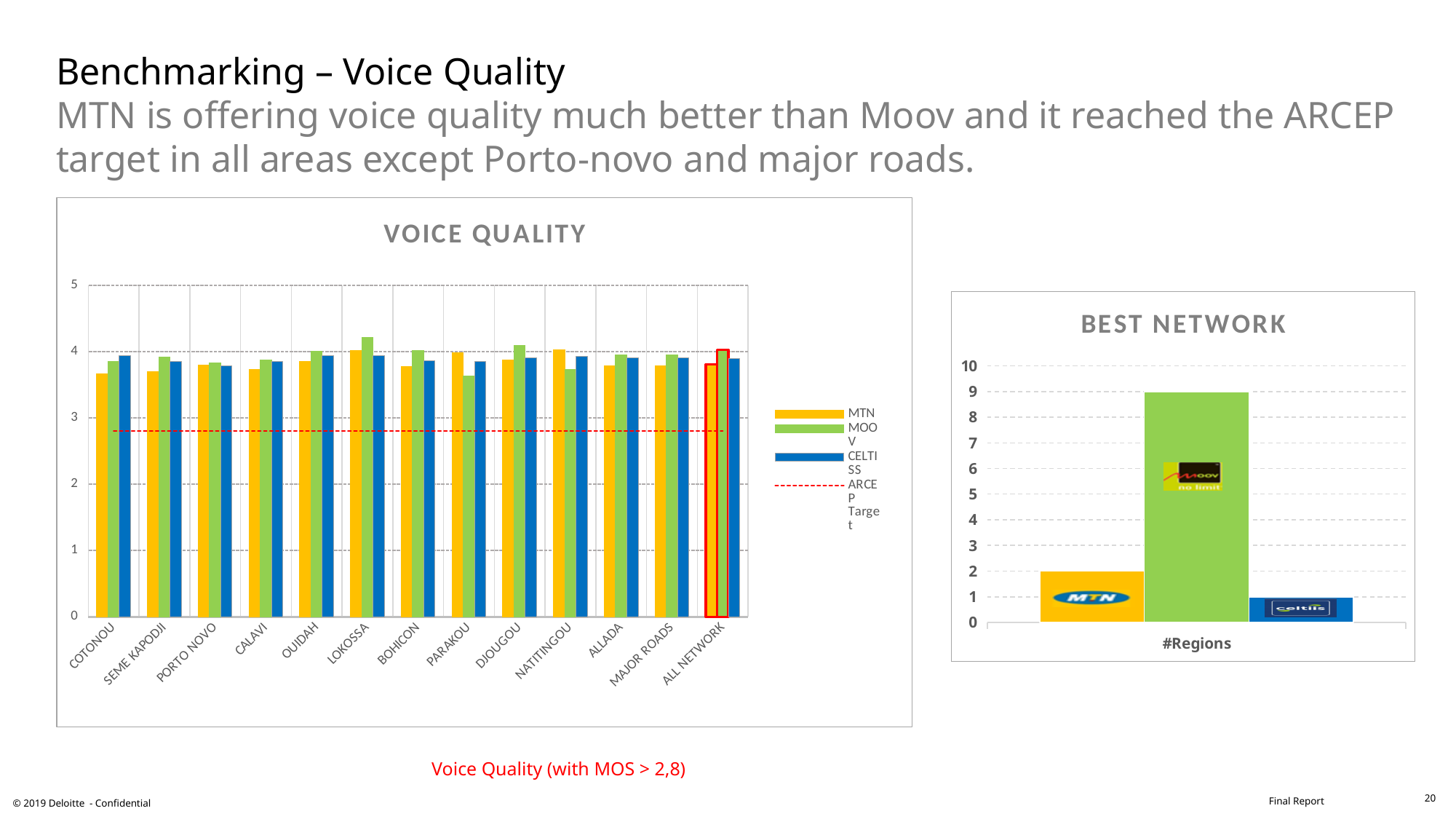
In the BEST NETWORK chart, which network has the lowest value? Celtis What kind of chart is the BEST NETWORK chart? bar chart In the BEST NETWORK chart, what is the difference between the Moov value and the MTN value? 7 How many categories are shown on the x axis of the VOICE QUALITY chart? 13 In the VOICE QUALITY chart, which is larger for PARAKOU: MTN or MOOV? MTN In the VOICE QUALITY chart, is the MTN value for COTONOU greater or less than 4? less What kind of chart is the VOICE QUALITY chart? bar chart How many entries does the legend of the VOICE QUALITY chart list? 4 In the VOICE QUALITY chart, what does the red dashed horizontal line represent? ARCEP Target In the BEST NETWORK chart, what is the value for MTN? 2 In the VOICE QUALITY chart, is the MOOV value for LOKOSSA greater or less than 4? greater In the BEST NETWORK chart, what is the value for Moov? 9